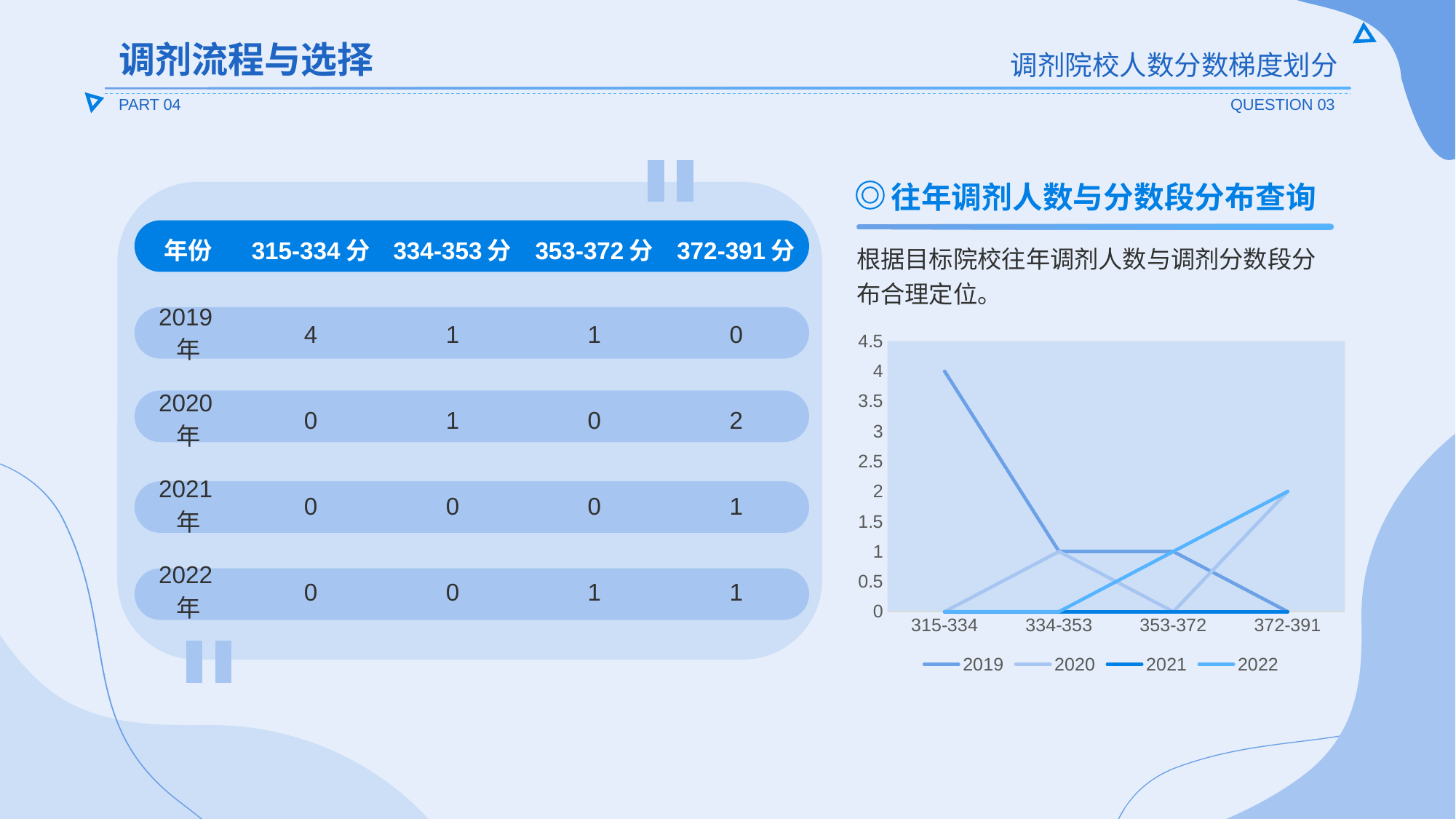
How many series does the chart legend list? 4 What kind of chart is shown on the slide? line chart What is the value for the 2021 series at 372-391? 0 Which score range has the highest value for the 2020 series? 372-391 Which score range has the highest value for the 2019 series? 315-334 What is the value for the 2019 series at 315-334? 4 What is the difference between the 2019 value at 315-334 and the 2019 value at 334-353? 3 How many score-range categories are shown on the x axis of the chart? 4 What is the value for the 2022 series at 353-372? 1 What is the value for the 2020 series at 372-391? 2 Does the 2019 series rise or fall from 315-334 to 372-391? fall